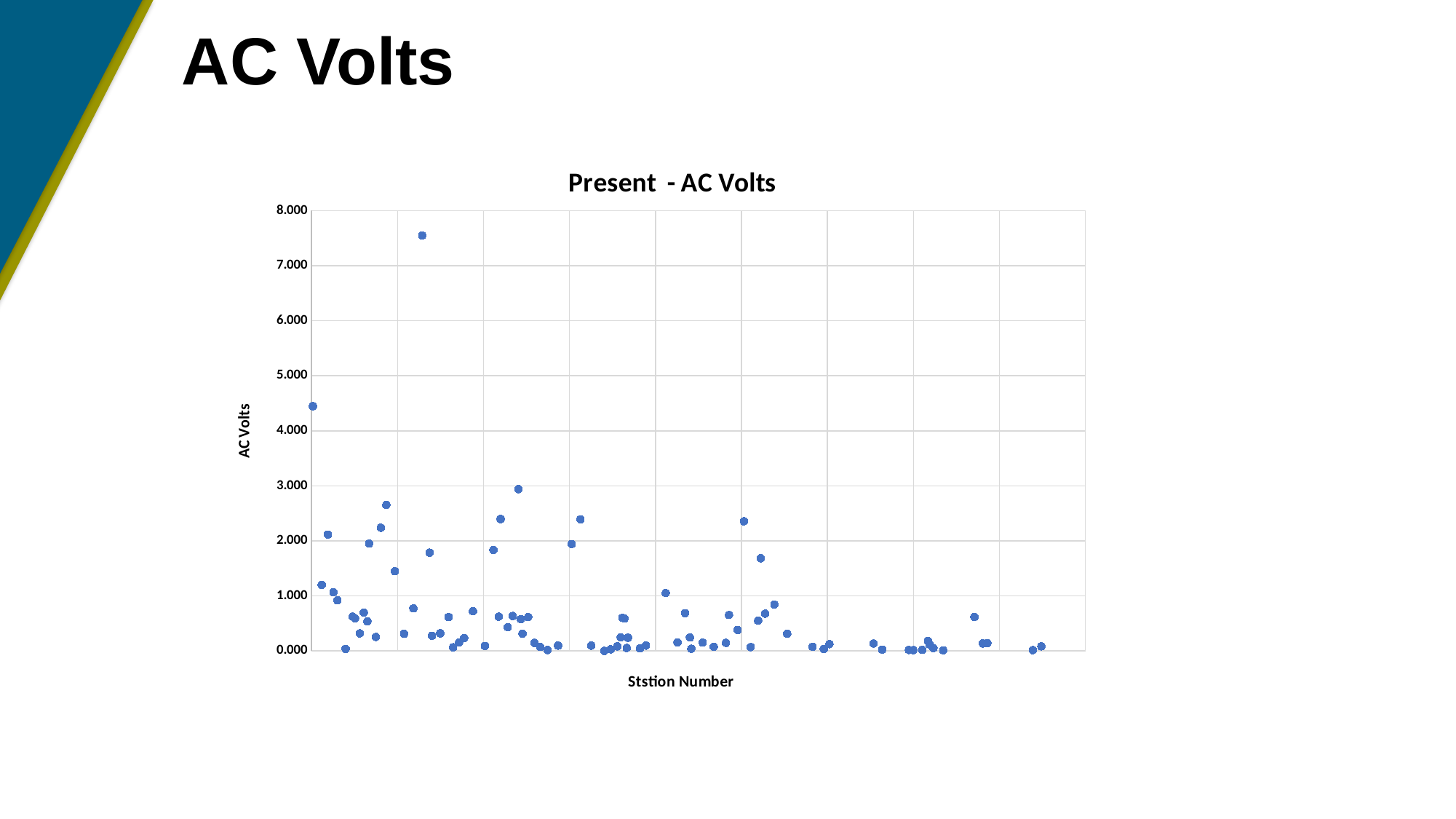
What kind of chart is shown on the slide? scatter chart What is the label on the vertical axis of the chart? AC Volts How many points on the chart lie above 5.000? 1 What is the title of the chart? Present - AC Volts Is the second-highest point on the chart greater or less than 4.000? greater Is the highest point on the chart greater or less than 7.000? greater What is the highest value shown on the vertical axis? 8.000 How many points on the chart lie above 6.000? 1 Is the highest point on the chart greater or less than 8.000? less